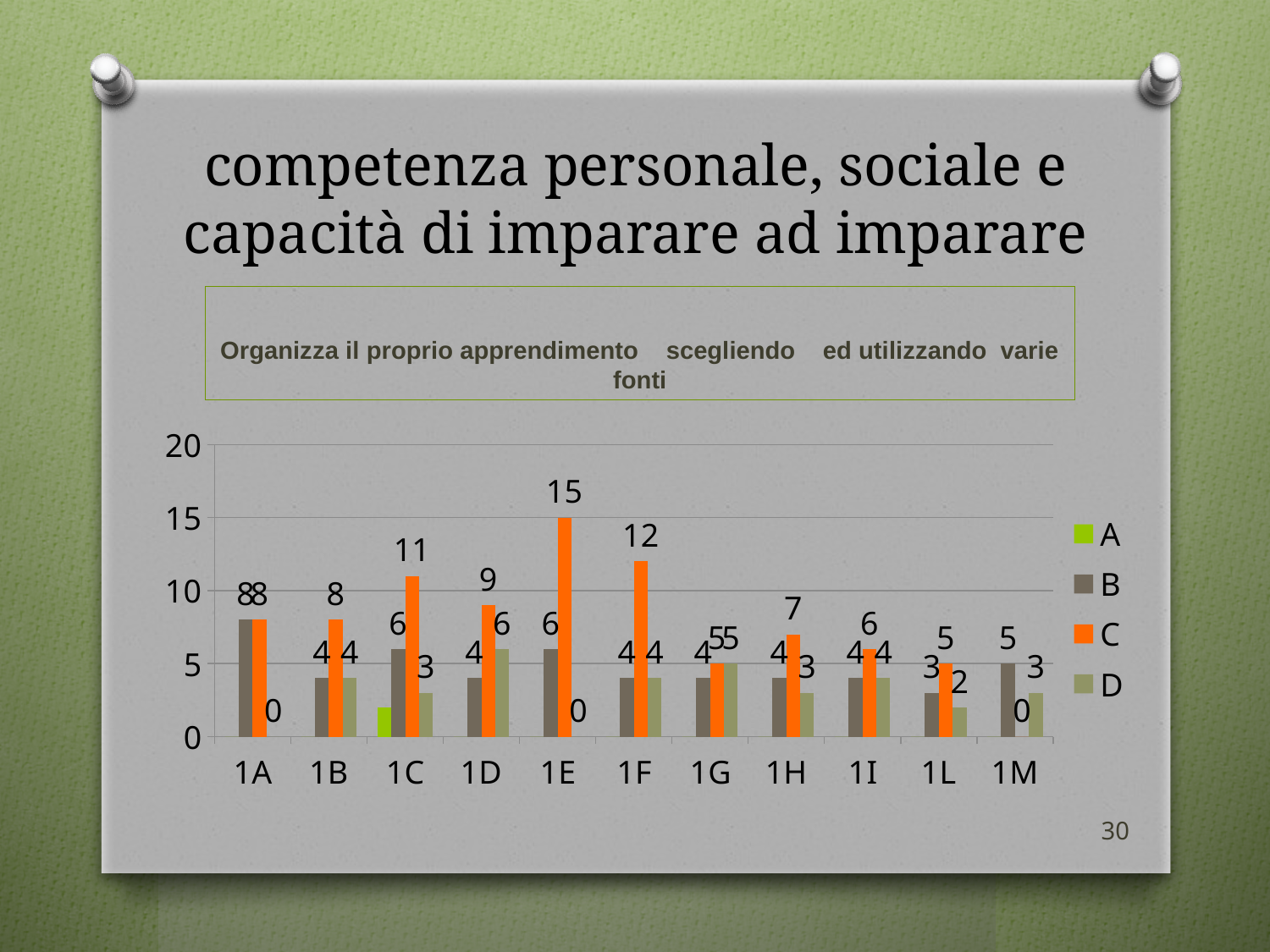
What is the difference between series C and series B for category 1E? 9 What is the value of series B for category 1M? 5 What are the entries listed in the legend? A, B, C, D What is the value of series C for category 1E? 15 Is the value of series C for category 1E greater or less than 10? greater Which category has the larger value for series C, 1C or 1D? 1C What is the value of series C for category 1F? 12 How many series does the legend list? 4 Which category has the highest value for series C? 1E What is the value of series D for category 1D? 6 What kind of chart is shown on the slide? bar chart How many categories are shown on the x axis? 11